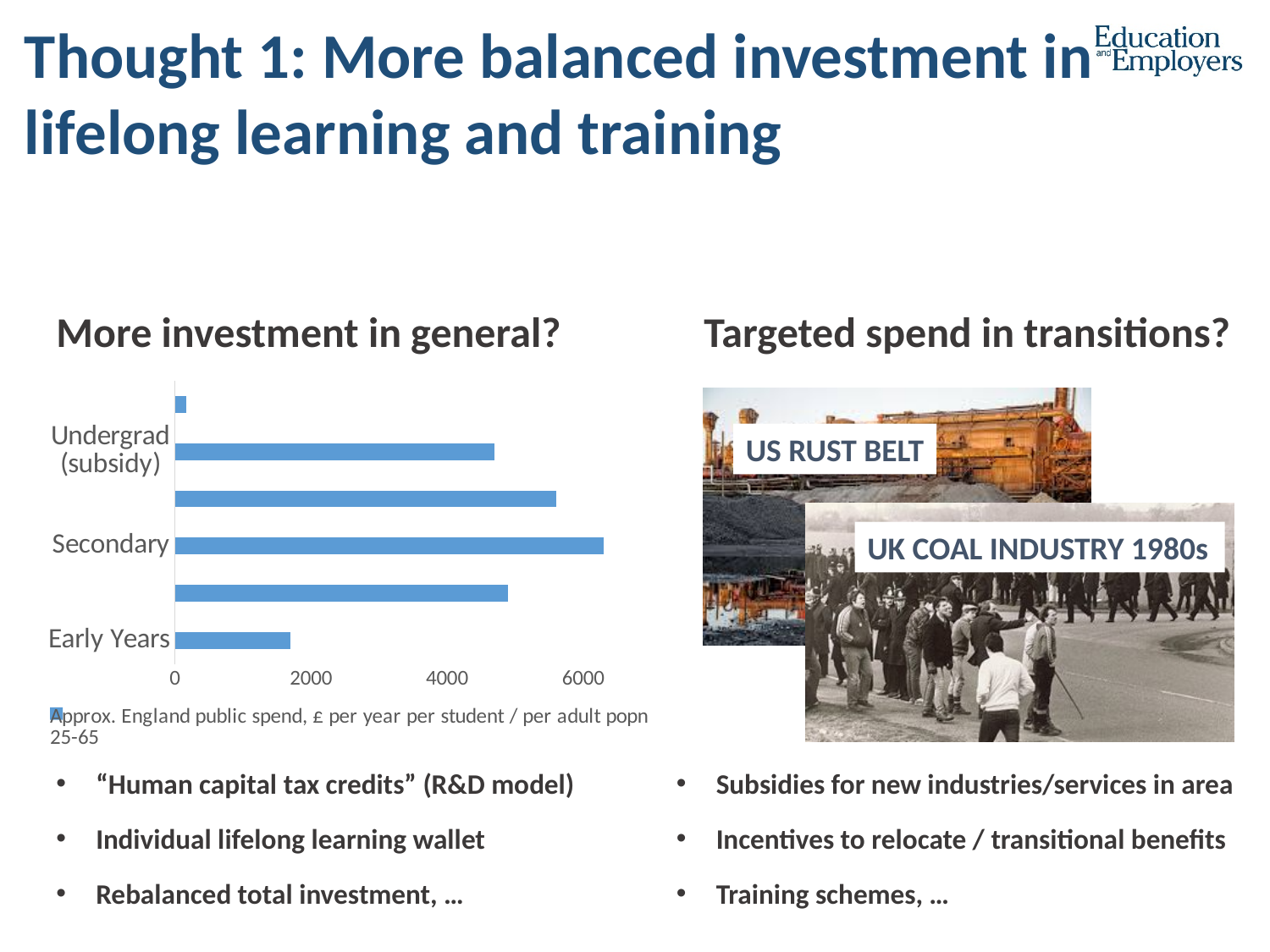
Is the value for Secondary greater or less than 6000? greater What is the highest tick value shown on the horizontal axis of the chart? 6000 How many bars are plotted in the chart? 6 Which of the labelled categories has the highest value? Secondary What kind of chart is shown under "More investment in general?"? bar chart Is the value for Undergrad (subsidy) greater or less than 4000? greater Is the value for Early Years greater or less than 2000? less What colour are the bars in the chart? blue Which is larger, the value for Secondary or the value for Early Years? Secondary Which is larger, the value for Undergrad (subsidy) or the value for Secondary? Secondary